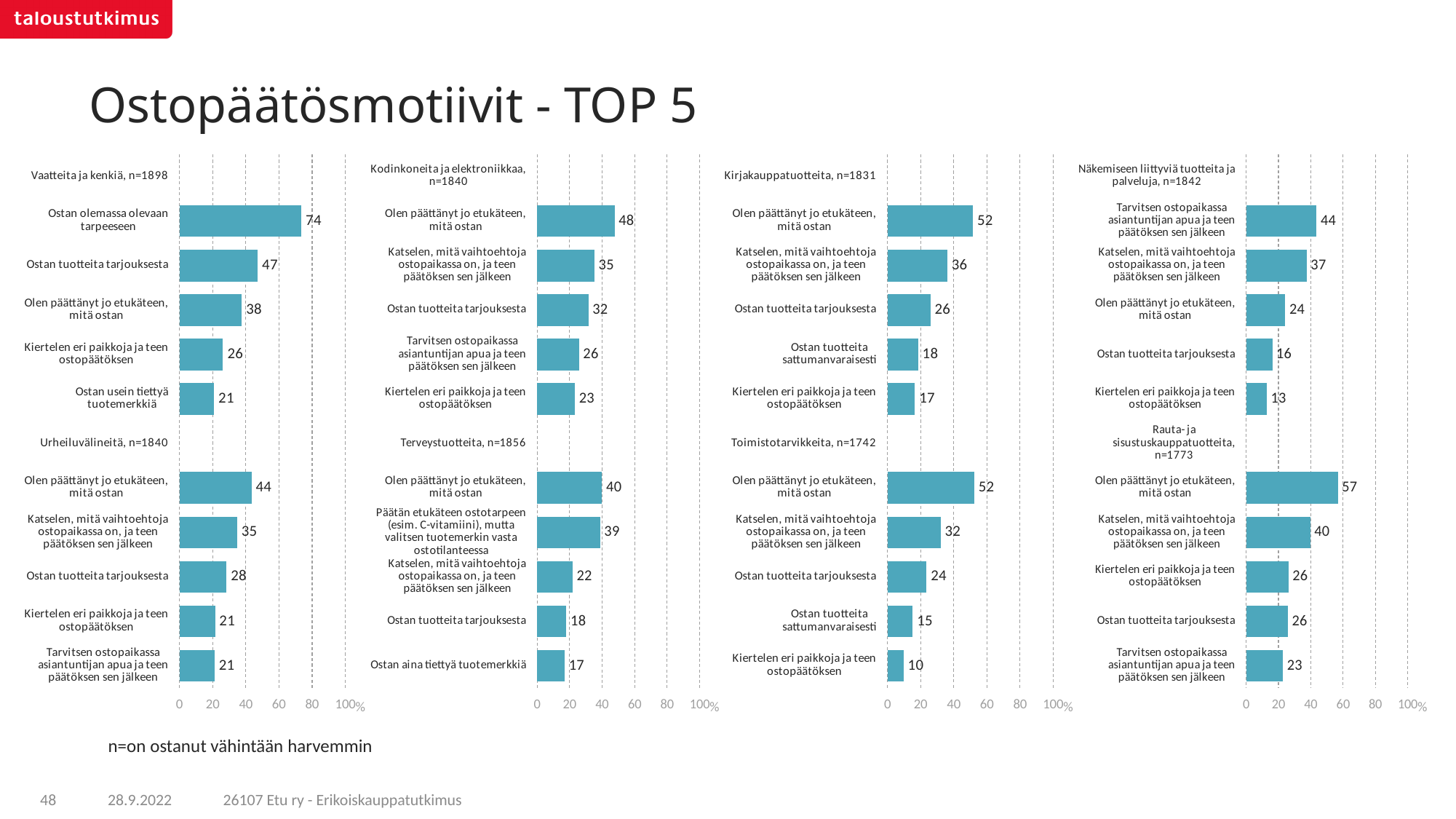
In the 'Terveystuotteita, n=1856' chart, which is larger: 'Olen päättänyt jo etukäteen, mitä ostan' or 'Ostan tuotteita tarjouksesta'? Olen päättänyt jo etukäteen, mitä ostan In the 'Toimistotarvikkeita, n=1742' chart, what is the difference between 'Olen päättänyt jo etukäteen, mitä ostan' and 'Katselen, mitä vaihtoehtoja ostopaikassa on, ja teen päätöksen sen jälkeen'? 20 In the 'Vaatteita ja kenkiä, n=1898' chart, what is the value for 'Ostan olemassa olevaan tarpeeseen'? 74 In the 'Toimistotarvikkeita, n=1742' chart, which category has the lowest value? Kiertelen eri paikkoja ja teen ostopäätöksen In the 'Kodinkoneita ja elektroniikkaa, n=1840' chart, what is the value for 'Ostan tuotteita tarjouksesta'? 32 In the 'Kirjakauppatuotteita, n=1831' chart, what is the difference between 'Olen päättänyt jo etukäteen, mitä ostan' and 'Ostan tuotteita tarjouksesta'? 26 In the 'Näkemiseen liittyviä tuotteita ja palveluja, n=1842' chart, is the value for 'Tarvitsen ostopaikassa asiantuntijan apua ja teen päätöksen sen jälkeen' greater or less than 40? greater What kind of chart is used for 'Vaatteita ja kenkiä, n=1898'? bar chart How many separate bar charts are shown on the slide? 4 In the 'Rauta- ja sisustuskauppatuotteita, n=1773' chart, which category has the highest value? Olen päättänyt jo etukäteen, mitä ostan How many categories are plotted in the 'Urheiluvälineitä, n=1840' chart? 5 In the 'Urheiluvälineitä, n=1840' chart, what is the value for 'Ostan tuotteita tarjouksesta'? 28